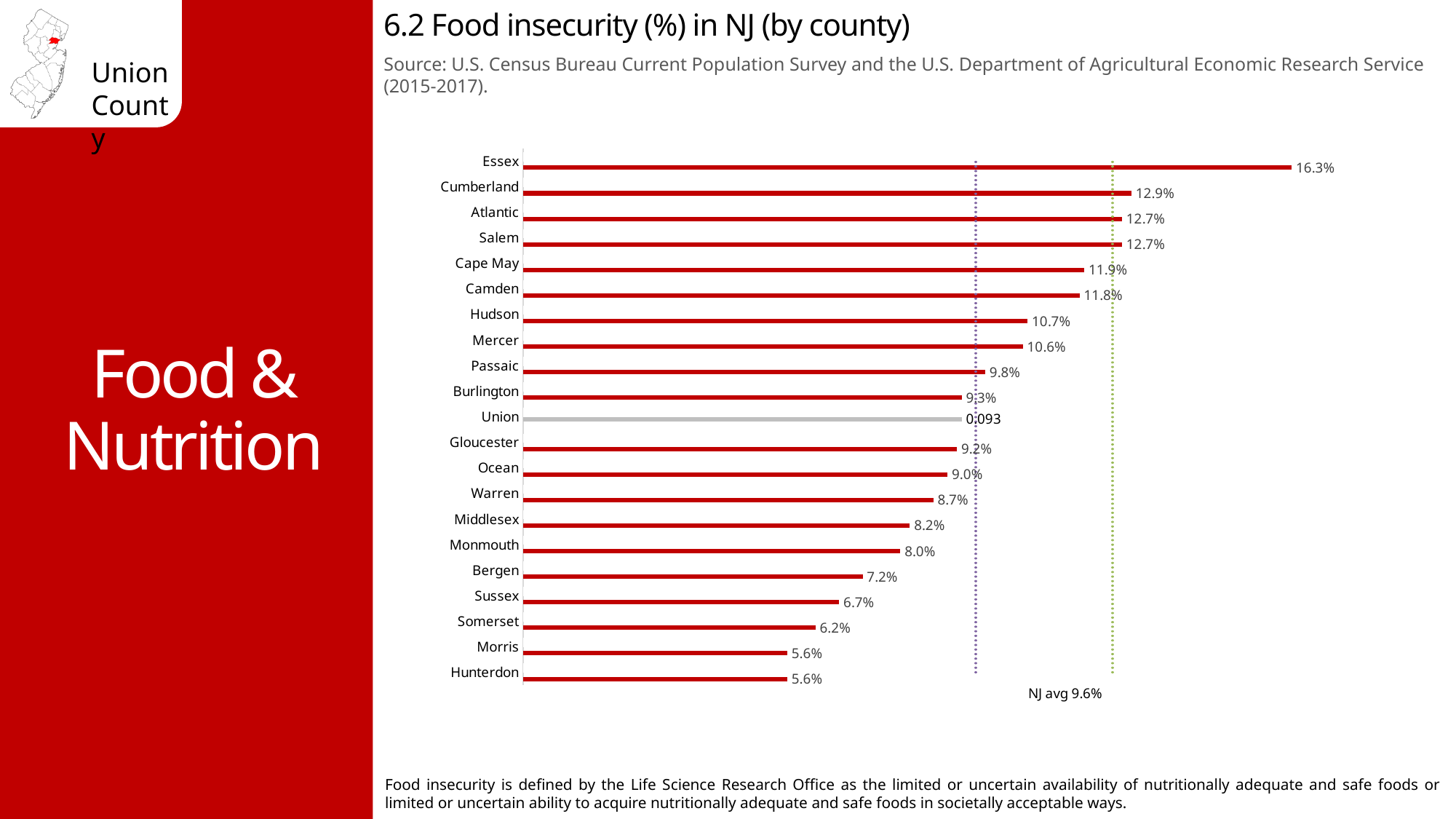
Which has a higher food insecurity value, Camden or Mercer? Camden What is the difference between the food insecurity values for Bergen and Sussex? 0.5% What kind of chart is shown on the slide? Bar chart Which has a higher food insecurity value, Warren or Middlesex? Warren What value is labeled for Union? 0.093 What is the food insecurity value for Essex? 16.3% What is the difference between the food insecurity values for Essex and Cumberland? 3.4% What is the NJ average food insecurity rate noted on the chart? 9.6% Which county has the highest food insecurity rate? Essex Which county's bar is drawn in grey rather than red? Union How many counties are shown in the chart? 21 What is the food insecurity value for Hudson? 10.7%